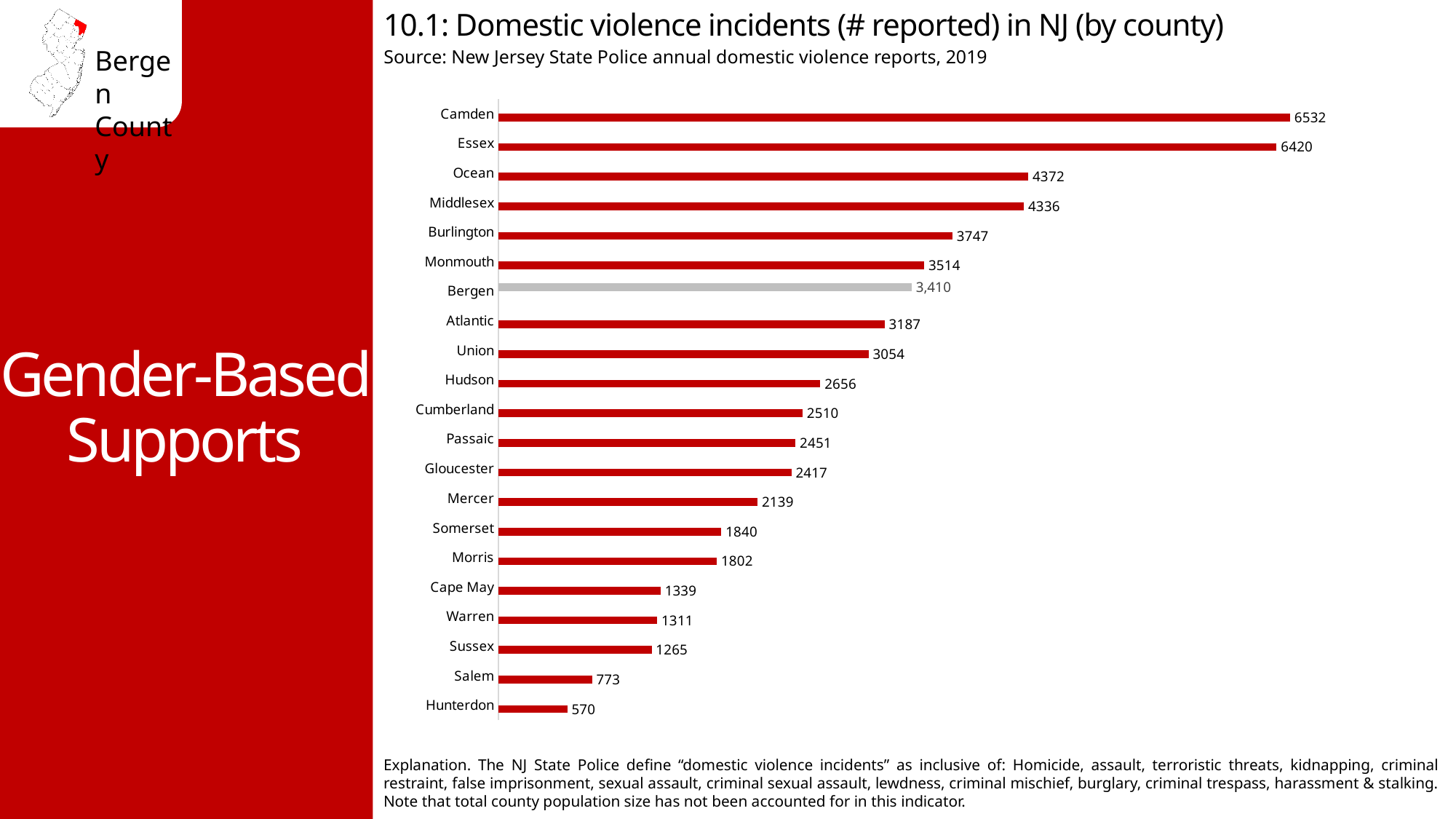
Which county's bar is shown in grey rather than red? Bergen Which county has more reported incidents, Ocean or Burlington? Ocean Which county has the highest number of reported domestic violence incidents? Camden What is the difference between the number of incidents reported in Monmouth and Bergen? 104 What is the number of reported domestic violence incidents for Hudson County? 2656 What is the number of reported domestic violence incidents for Bergen County? 3,410 How many counties are shown in the chart? 21 What is the number of reported domestic violence incidents for Camden County? 6532 Which county has the lowest number of reported domestic violence incidents? Hunterdon What is the difference between the number of incidents reported in Camden and Essex? 112 What kind of chart is shown on the slide? Bar chart Which county has more reported incidents, Salem or Sussex? Sussex